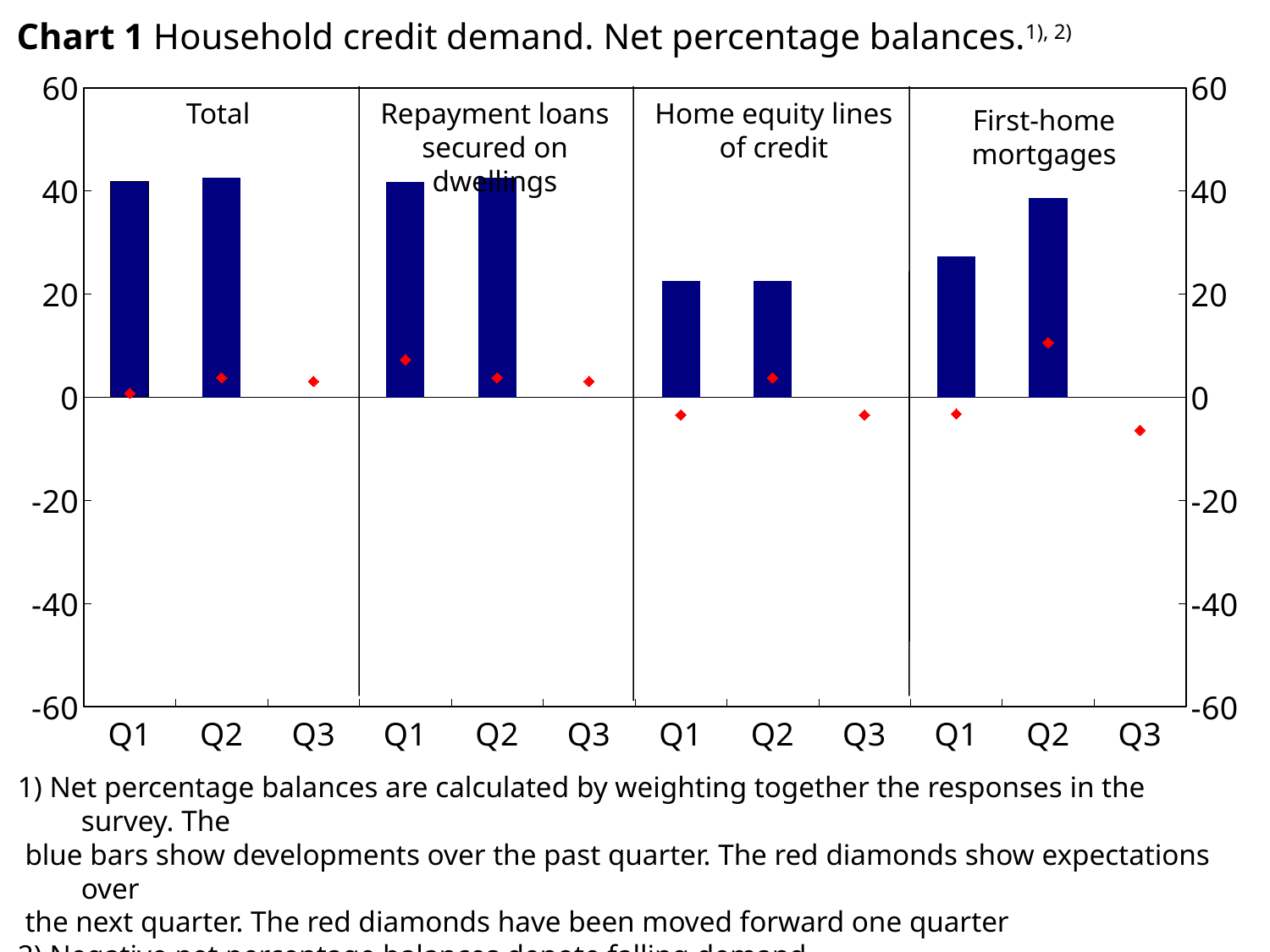
In the First-home mortgages panel, is the Q3 red diamond greater or less than 0? less According to the footnote, what do the red diamonds show? expectations over the next quarter How many quarters are shown on the x axis within each panel of Chart 1? 3 What kind of chart is Chart 1? bar chart Which panel has the lowest Q2 bar? Home equity lines of credit Which is larger, the Q2 bar in the Total panel or the Q2 bar in the Home equity lines of credit panel? Total In the First-home mortgages panel, is the Q2 red diamond greater or less than 0? greater In the Total panel, is the Q1 bar greater or less than 40? greater How many credit categories (panels) are shown in Chart 1? 4 In the First-home mortgages panel, which bar is taller, Q1 or Q2? Q2